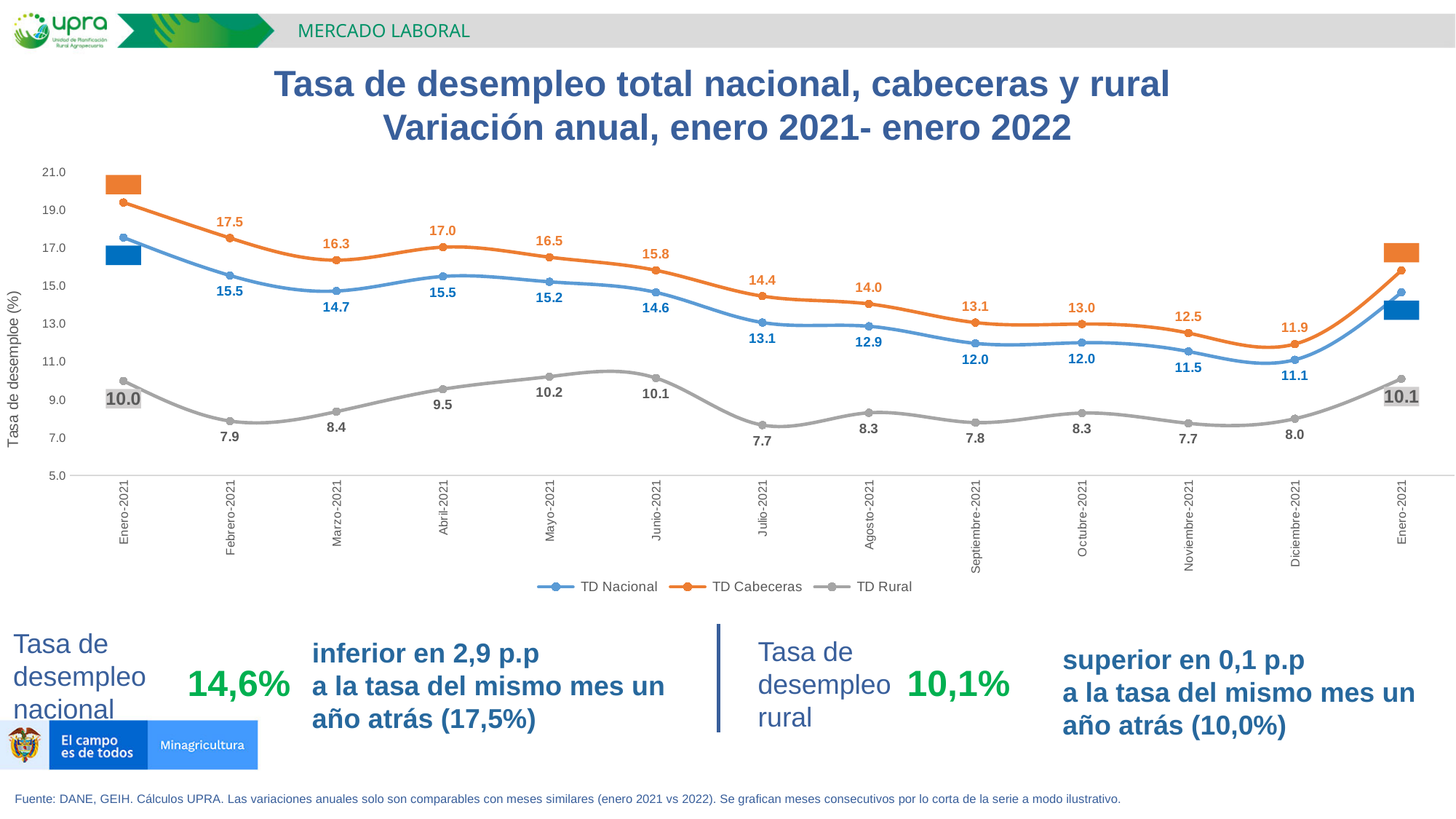
In which month does TD Nacional reach its lowest value? Diciembre-2021 Which is larger for TD Nacional: Abril-2021 or Mayo-2021? Abril-2021 How many series does the legend list? 3 In which month does TD Rural reach its highest labeled value? Mayo-2021 How many months are plotted on the x axis? 13 What is the value of TD Rural for Julio-2021? 7.7 Is the value for TD Nacional at the first point (Enero-2021) greater or less than 15.0? greater Does TD Cabeceras rise or fall from Febrero-2021 to Diciembre-2021? fall What is the value of TD Nacional for Marzo-2021? 14.7 What kind of chart is shown on the slide? line chart What is the value of TD Cabeceras for Febrero-2021? 17.5 What is the difference between TD Cabeceras and TD Nacional in Junio-2021? 1.2